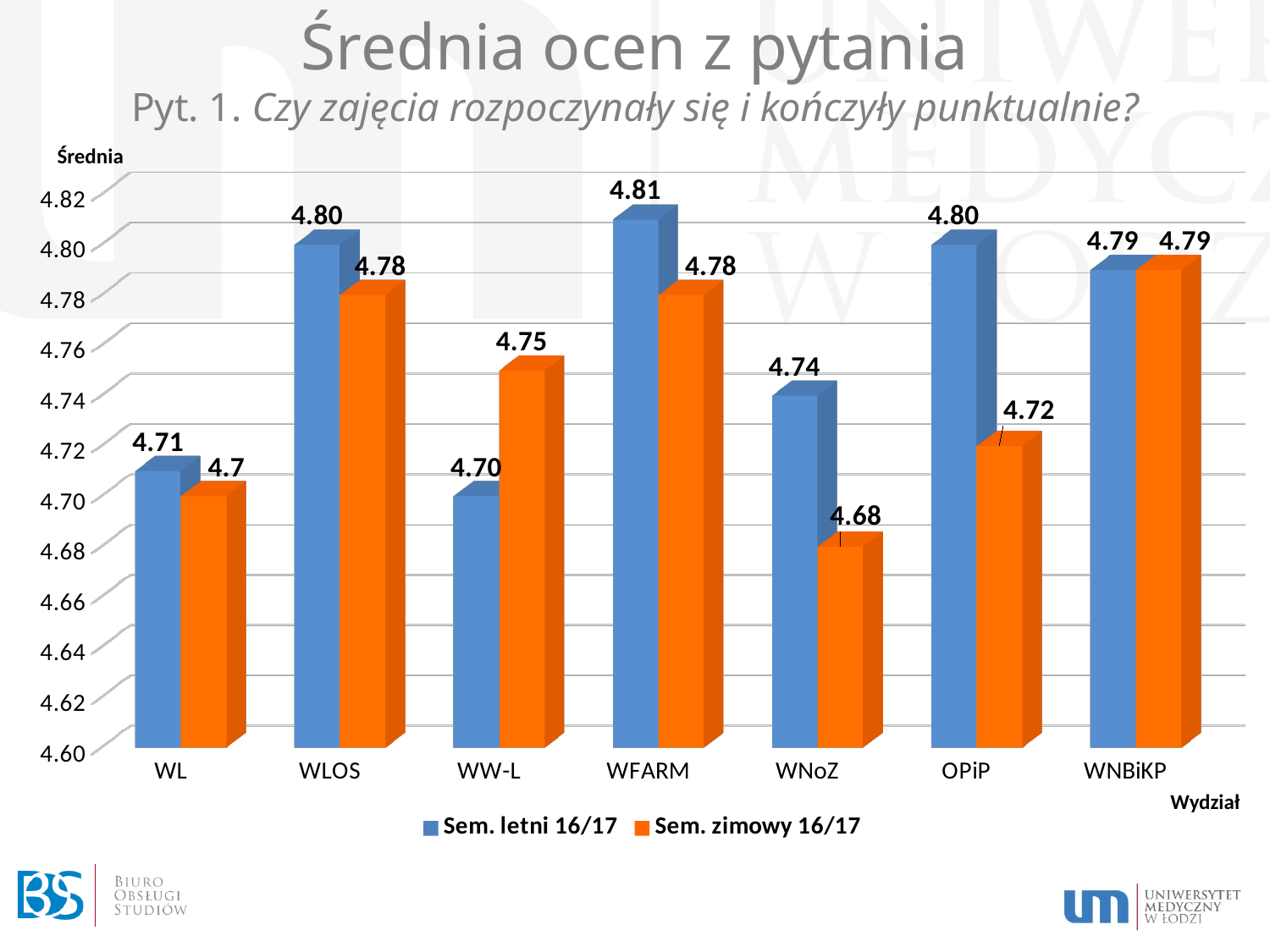
Which colour represents the Sem. zimowy 16/17 series? Orange How many categories are shown on the x axis? 7 What is the value for WNoZ in the Sem. zimowy 16/17 series? 4.68 Which category has the lowest value in the Sem. zimowy 16/17 series? WNoZ What is the value for WL in the Sem. zimowy 16/17 series? 4.7 What is the label of the x axis? Wydział What kind of chart is shown on the slide? Bar chart What is the difference between the Sem. letni 16/17 and Sem. zimowy 16/17 values for OPiP? 0.08 For WW-L, which series has the larger value, Sem. letni 16/17 or Sem. zimowy 16/17? Sem. zimowy 16/17 Which category has the highest value in the Sem. letni 16/17 series? WFARM How many series does the legend list? 2 What is the value for WFARM in the Sem. letni 16/17 series? 4.81